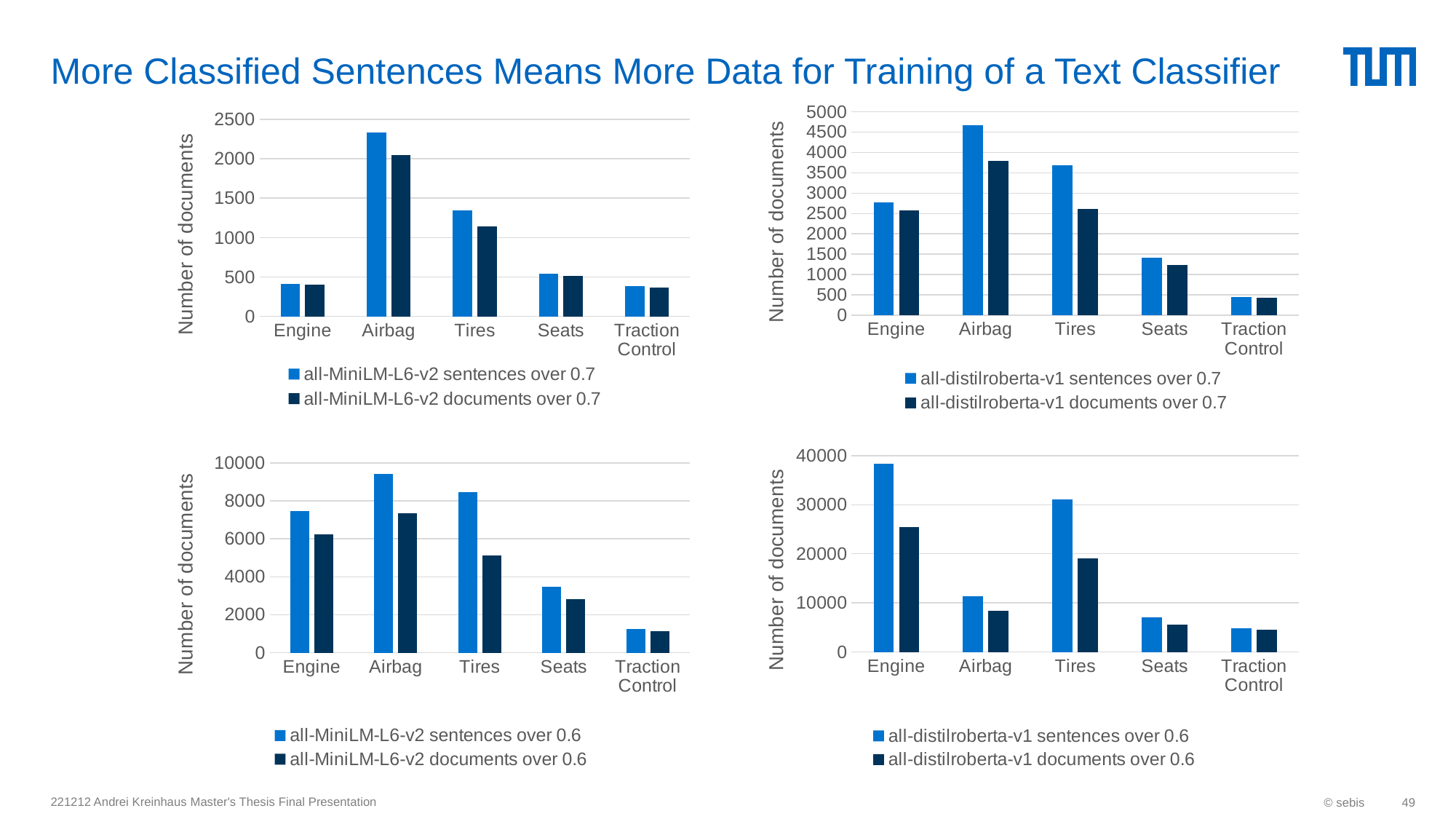
In the bottom-left chart, is the value for Engine sentences over 0.6 greater or less than 6000? greater In the bottom-right chart (all-distilroberta-v1 over 0.6), which category has the highest number of documents? Engine In the bottom-right chart, which category is larger: Airbag or Tires? Tires How many series does the legend of the top-right chart list? 2 In the top-right chart, which is larger for Tires: sentences over 0.7 or documents over 0.7? sentences over 0.7 In the top-left chart (all-MiniLM-L6-v2 over 0.7), which category has the highest number of documents? Airbag In the bottom-left chart (all-MiniLM-L6-v2 over 0.6), which category has the lowest number of documents? Traction Control In the top-right chart (all-distilroberta-v1 over 0.7), which category has the lowest number of documents? Traction Control In the top-left chart, is the value for Airbag sentences over 0.7 greater or less than 2000? greater What kind of chart is the top-left chart on the slide? bar chart In the bottom-right chart, is the value for Engine sentences over 0.6 greater or less than 30000? greater How many categories are shown on the x axis of the bottom-right chart? 5